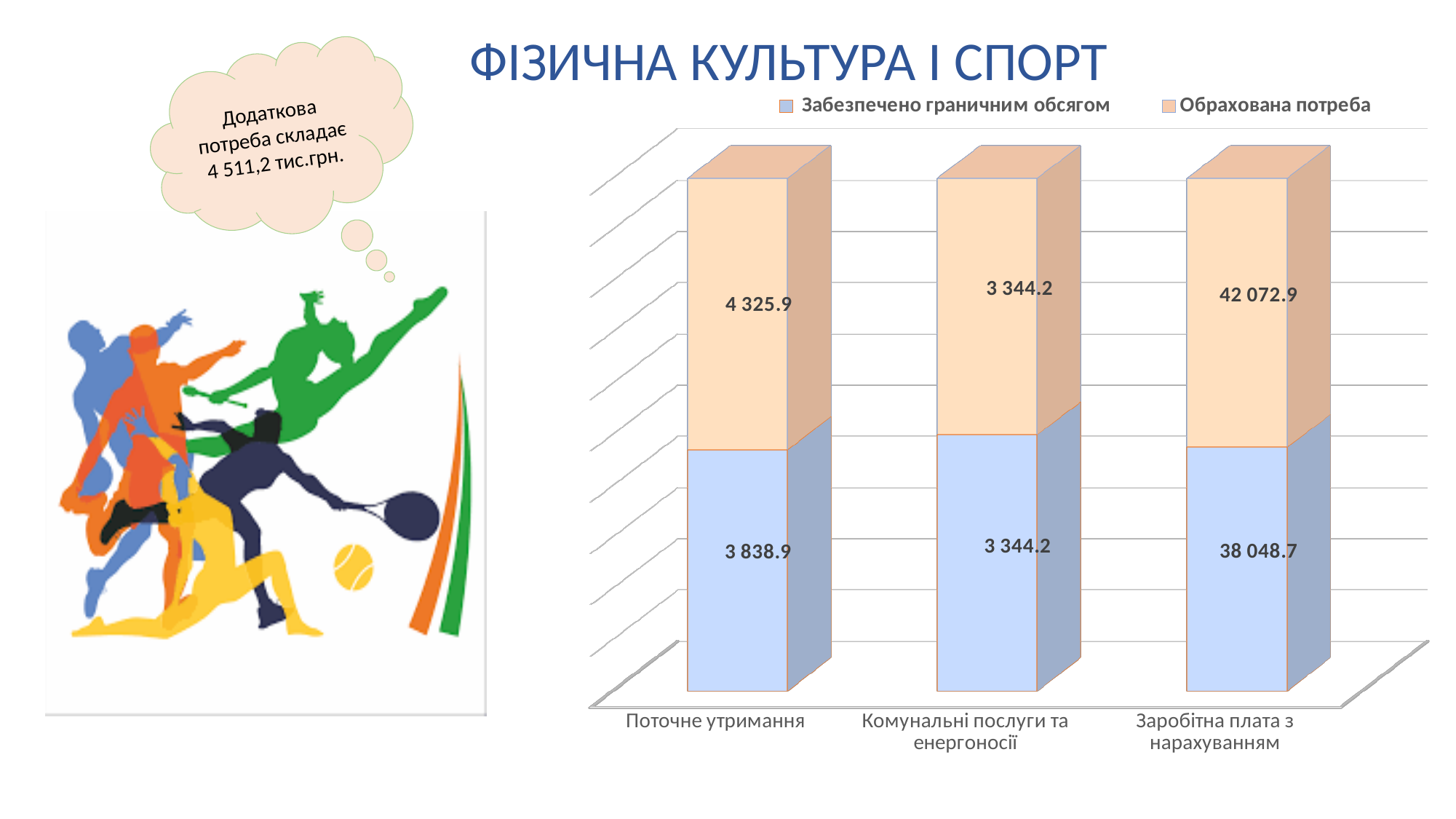
What is the total of the two labelled values in the "Поточне утримання" bar? 8 164.8 What kind of chart is shown on the slide? Stacked bar chart What is the difference between "Обрахована потреба" and "Забезпечено граничним обсягом" for "Поточне утримання"? 487.0 How many series does the chart legend list? 2 Which category has the highest value for "Обрахована потреба"? Заробітна плата з нарахуванням What is the difference between "Обрахована потреба" and "Забезпечено граничним обсягом" for "Заробітна плата з нарахуванням"? 4 024.2 What value is shown for "Забезпечено граничним обсягом" in the "Комунальні послуги та енергоносії" category? 3 344.2 For "Поточне утримання", which is larger: "Обрахована потреба" or "Забезпечено граничним обсягом"? Обрахована потреба What value is shown for "Забезпечено граничним обсягом" in the "Заробітна плата з нарахуванням" category? 38 048.7 How many categories are shown on the x axis of the chart? 3 What value is shown for "Обрахована потреба" in the "Поточне утримання" category? 4 325.9 Which category has the lowest value for "Забезпечено граничним обсягом"? Комунальні послуги та енергоносії